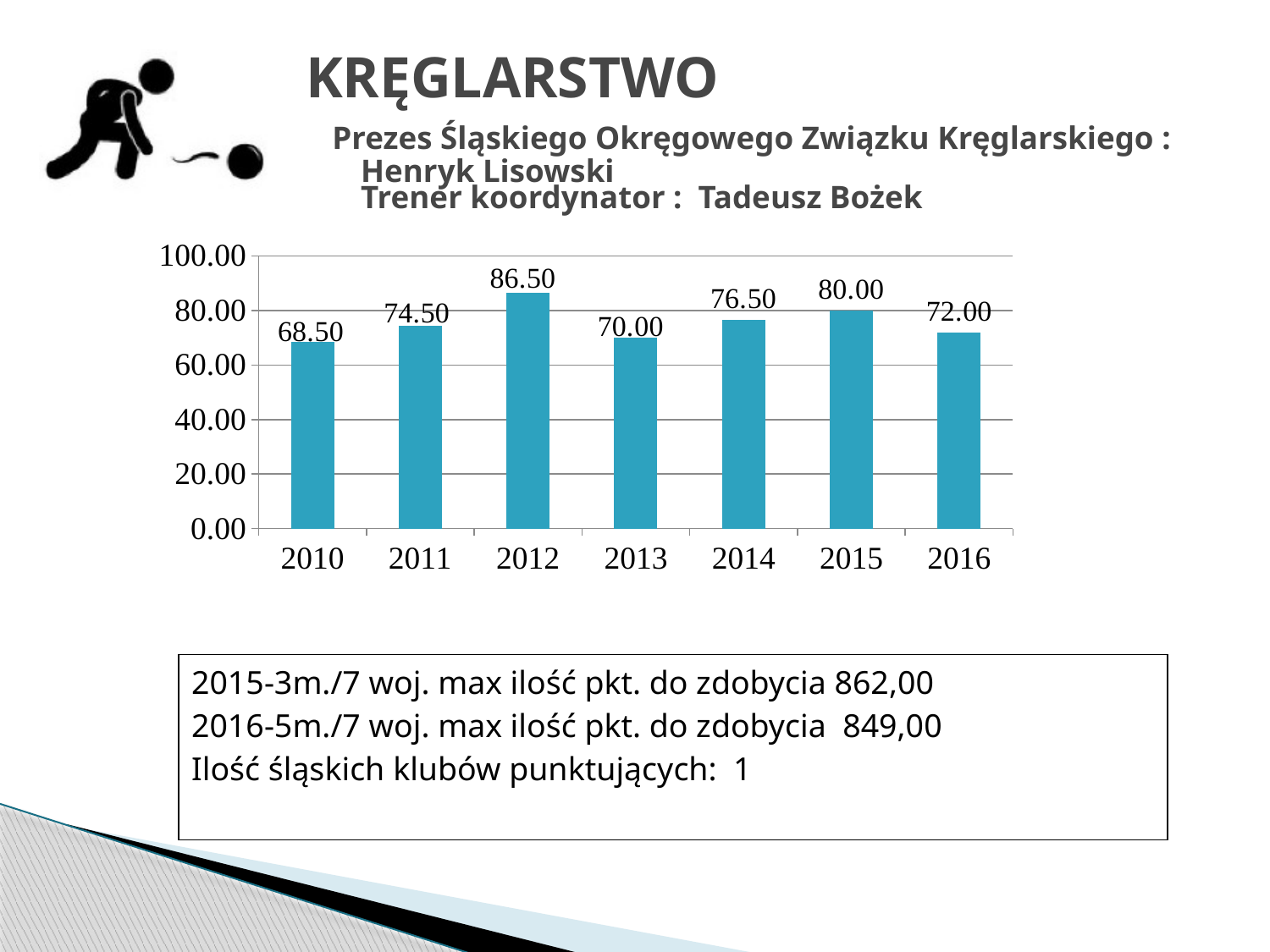
Which year has the highest value? 2012 Which is larger, the value for 2011 or the value for 2014? 2014 Which year has the lowest value? 2010 How many years are shown on the x axis? 7 What is the value for 2010? 68.50 What kind of chart is shown on the slide? bar chart What is the difference between the values for 2012 and 2013? 16.50 What is the value for 2015? 80.00 What is the value for 2012? 86.50 Do the values rise or fall from 2013 to 2015? rise Is the value for 2013 greater or less than 80.00? less What is the difference between the values for 2015 and 2016? 8.00